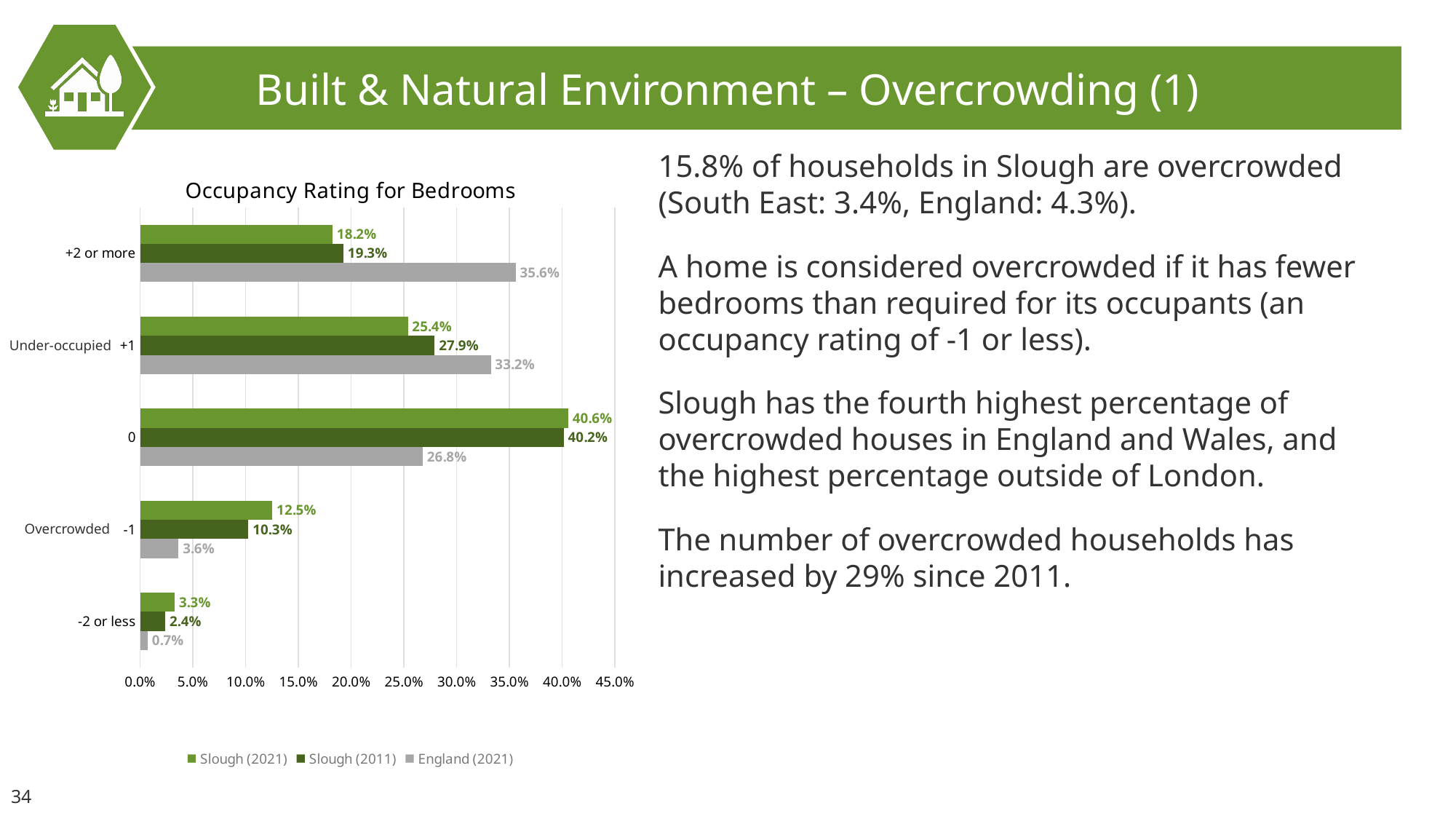
Which occupancy rating category has the lowest England (2021) value? -2 or less How many series does the chart legend list? 3 What is the difference between the Slough (2021) and England (2021) values for the '-1' occupancy rating? 8.9% How many occupancy rating categories are shown on the chart? 5 Which occupancy rating category has the highest Slough (2021) value? 0 What is the title of the chart? Occupancy Rating for Bedrooms What kind of chart is shown on the slide? Bar chart What is the Slough (2011) value for the '-1' (Overcrowded) occupancy rating? 10.3% What is the England (2021) value for the '+2 or more' occupancy rating? 35.6% Which is larger for the '+1' occupancy rating: Slough (2021) or Slough (2011)? Slough (2011) Is the England (2021) value for the '0' occupancy rating greater or less than 30.0%? less What is the Slough (2021) value for the '0' occupancy rating? 40.6%